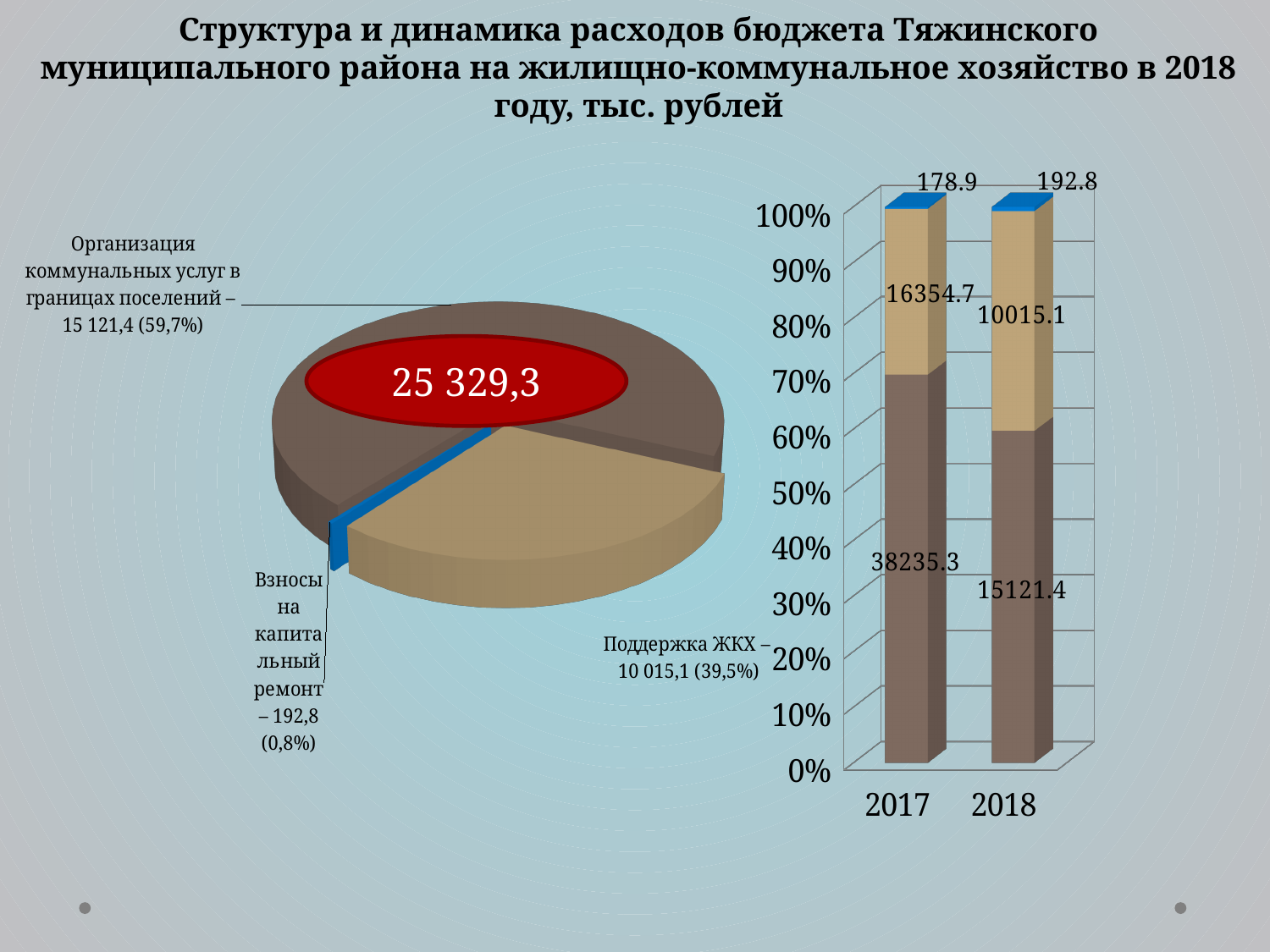
In the stacked bar chart on the right, what is the value of the middle (tan) segment for 2018? 10015.1 What type of chart is shown on the right side of the slide? Stacked bar chart In the stacked bar chart on the right, what is the value of the bottom (brown) segment for 2017? 38235.3 How many slices does the pie chart on the left have? 3 In the pie chart on the left, what total value is printed in the red oval at the centre? 25 329,3 In the pie chart on the left, what is the value shown for Поддержка ЖКХ? 10 015,1 (39,5%) In the pie chart on the left, what share of the pie does Организация коммунальных услуг в границах поселений take? 59,7% In the stacked bar chart on the right, what is the value of the top (blue) segment for 2018? 192.8 In the pie chart on the left, which category has the largest slice? Организация коммунальных услуг в границах поселений In the pie chart on the left, which category has the smallest slice? Взносы на капитальный ремонт In the stacked bar chart on the right, what is the difference between the bottom segment values for 2017 and 2018? 23113.9 In the stacked bar chart on the right, which year has the larger value for the top (blue) segment, 2017 or 2018? 2018